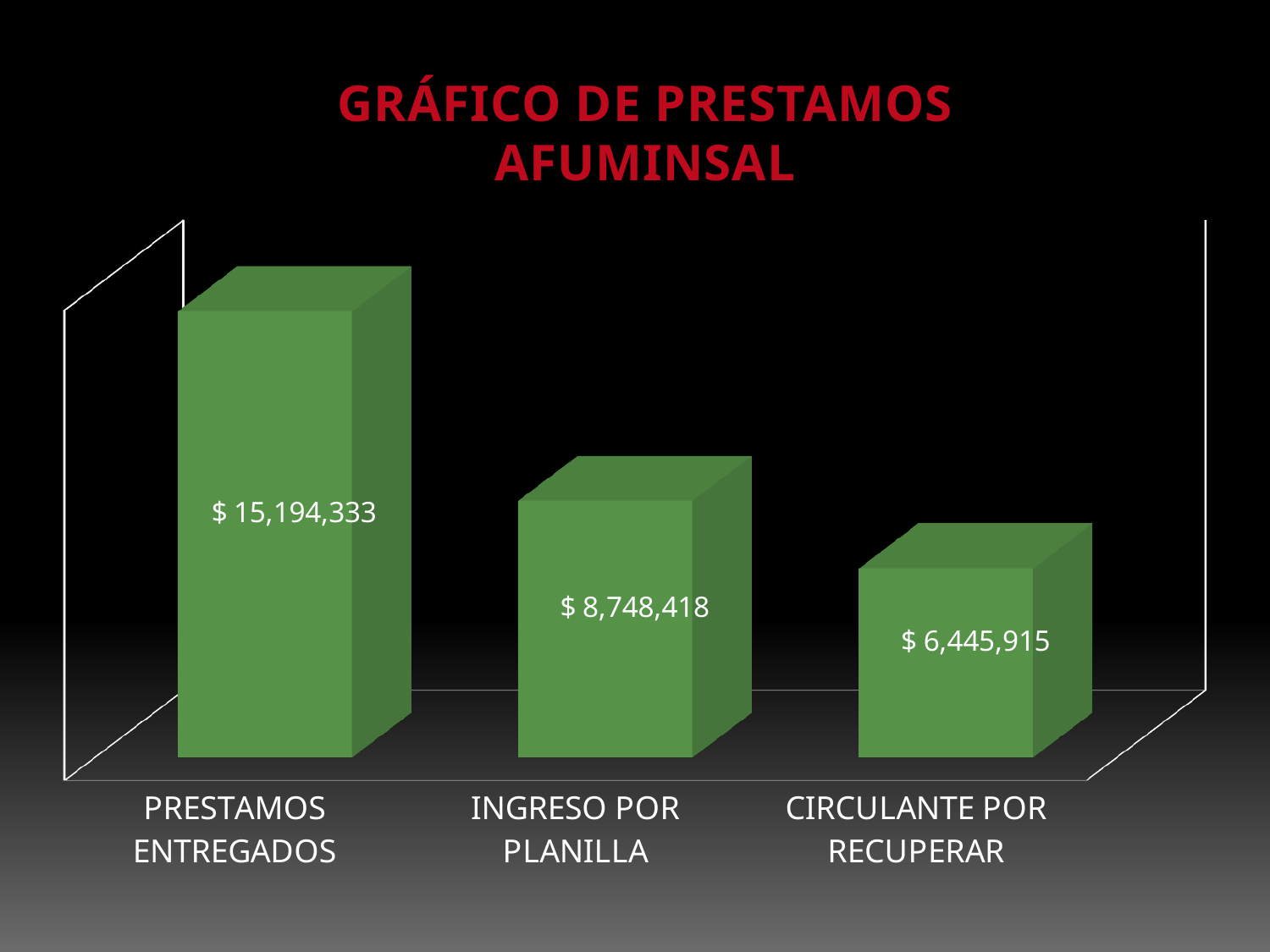
Which is larger, INGRESO POR PLANILLA or CIRCULANTE POR RECUPERAR? INGRESO POR PLANILLA What is the difference between INGRESO POR PLANILLA and CIRCULANTE POR RECUPERAR? $ 2,302,503 What is the difference between PRESTAMOS ENTREGADOS and INGRESO POR PLANILLA? $ 6,445,915 What kind of chart is shown on the slide? Bar chart How many categories are shown in the chart? 3 Which category has the lowest value? CIRCULANTE POR RECUPERAR What is the value for INGRESO POR PLANILLA? $ 8,748,418 Do the values rise or fall from left to right across the categories? Fall What is the value for PRESTAMOS ENTREGADOS? $ 15,194,333 What is the title of the chart? GRÁFICO DE PRESTAMOS AFUMINSAL What is the value for CIRCULANTE POR RECUPERAR? $ 6,445,915 Which category has the highest value? PRESTAMOS ENTREGADOS